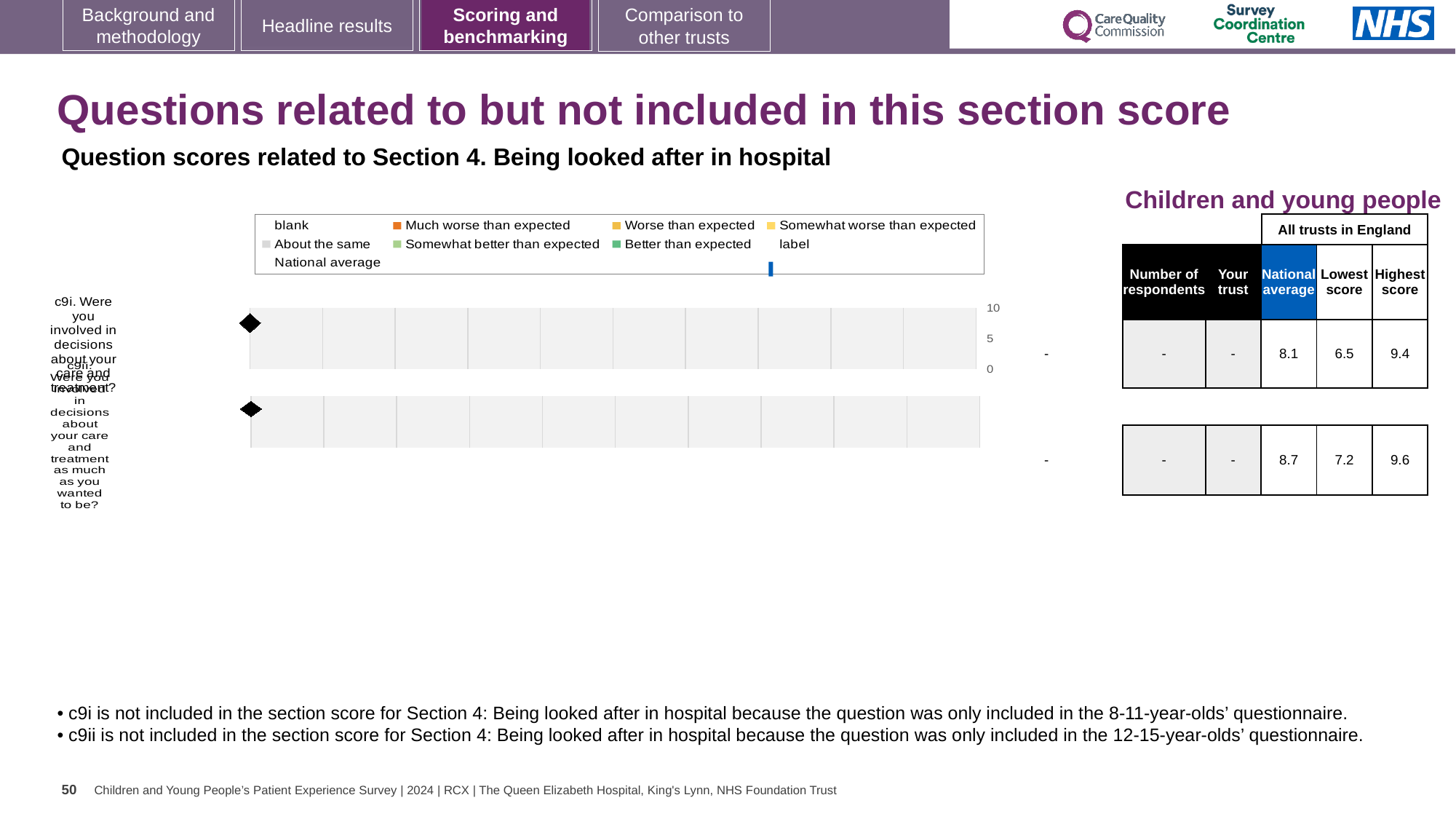
What is the subtitle printed above the chart? Question scores related to Section 4. Being looked after in hospital In the table beside the chart, what is the difference between the national averages of c9ii and c9i? 0.6 In the table beside the chart, what is the highest score for c9ii? 9.6 In the table beside the chart, what is the national average score for c9i? 8.1 In the table beside the chart, which question has the lower lowest score, c9i or c9ii? c9i In the table beside the chart, what is the lowest score for c9ii? 7.2 In the table beside the chart, what is the difference between the highest score and the lowest score for c9i? 2.9 What is the highest tick value shown on the chart's score axis? 10 How many entries does the chart's legend list? 9 In the table beside the chart, which question has the higher national average, c9i or c9ii? c9ii What kind of chart is shown on the slide? bar chart How many questions (categories) are listed on the chart's vertical axis? 2